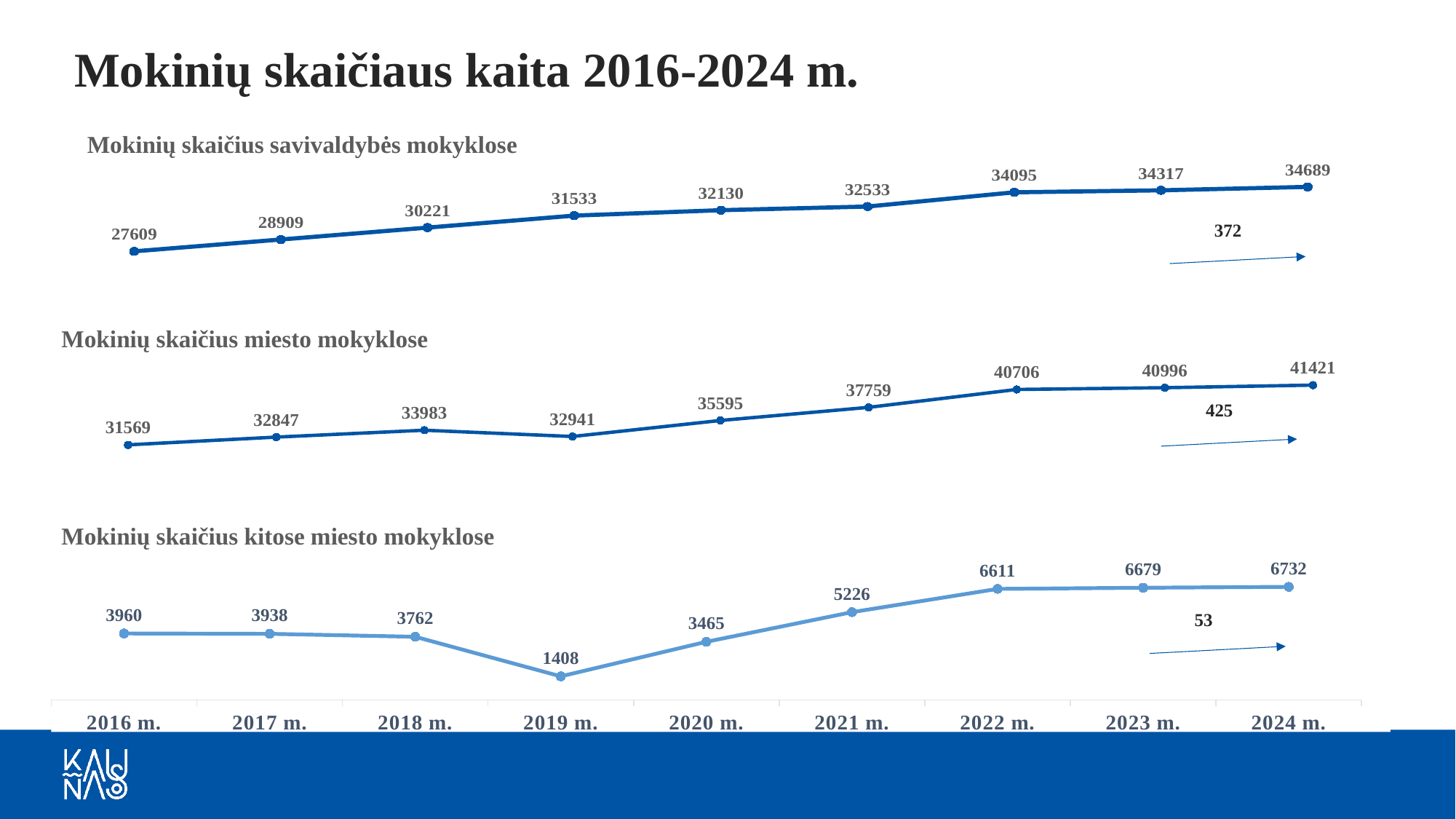
What type of chart is 'Mokinių skaičius miesto mokyklose'? Line chart In the chart 'Mokinių skaičius miesto mokyklose', which year has the highest value? 2024 m. In the chart 'Mokinių skaičius kitose miesto mokyklose', which year has the lowest value? 2019 m. In the chart 'Mokinių skaičius savivaldybės mokyklose', what is the value for 2024 m.? 34689 In the chart 'Mokinių skaičius savivaldybės mokyklose', what is the value for 2016 m.? 27609 In the chart 'Mokinių skaičius kitose miesto mokyklose', what is the value for 2021 m.? 5226 In the chart 'Mokinių skaičius savivaldybės mokyklose', what is the difference between the 2024 m. and 2023 m. values? 372 In the chart 'Mokinių skaičius kitose miesto mokyklose', what is the difference between the 2022 m. and 2020 m. values? 3146 In the chart 'Mokinių skaičius savivaldybės mokyklose', do the values rise or fall from 2016 m. to 2024 m.? Rise In the chart 'Mokinių skaičius miesto mokyklose', which is larger, the value for 2018 m. or 2019 m.? 2018 m. How many data points does the chart 'Mokinių skaičius savivaldybės mokyklose' have? 9 In the chart 'Mokinių skaičius miesto mokyklose', what is the value for 2019 m.? 32941